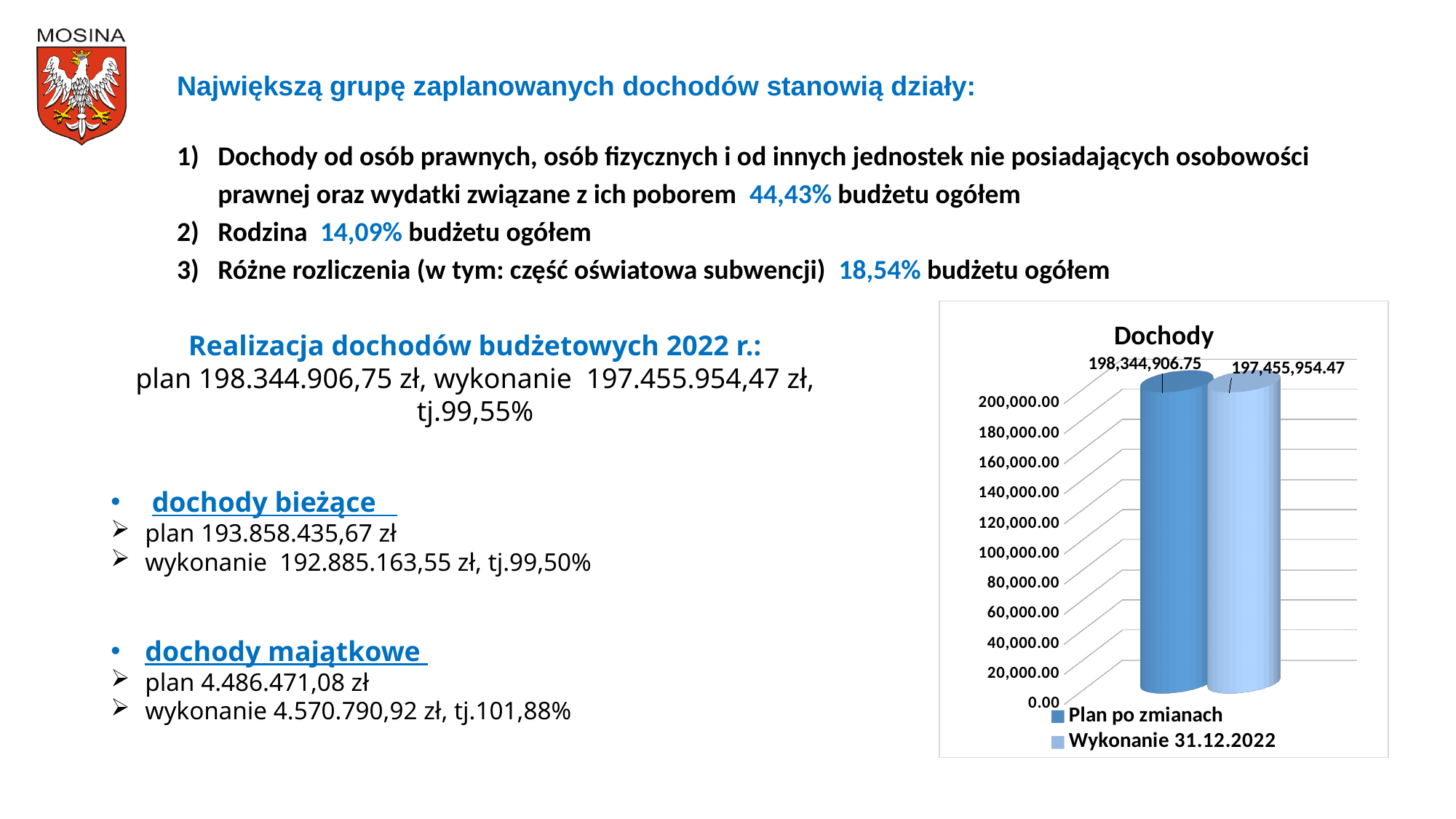
What is the title of the chart on the slide? Dochody Which series has the lowest value in the Dochody chart? Wykonanie 31.12.2022 What are the two legend entries in the Dochody chart? Plan po zmianach; Wykonanie 31.12.2022 What is the highest tick value shown on the vertical axis of the Dochody chart? 200,000.00 Which series has the higher value in the Dochody chart, Plan po zmianach or Wykonanie 31.12.2022? Plan po zmianach What is the value shown for Wykonanie 31.12.2022 in the Dochody chart? 197,455,954.47 What kind of chart is shown on the slide? bar chart What is the value shown for Plan po zmianach in the Dochody chart? 198,344,906.75 How many series does the legend of the Dochody chart list? 2 How many bars are plotted in the Dochody chart? 2 What is the difference between the Plan po zmianach value and the Wykonanie 31.12.2022 value in the Dochody chart? 888,952.28 Is the bar for Plan po zmianach in the Dochody chart greater or less than the 100,000.00 axis line? greater